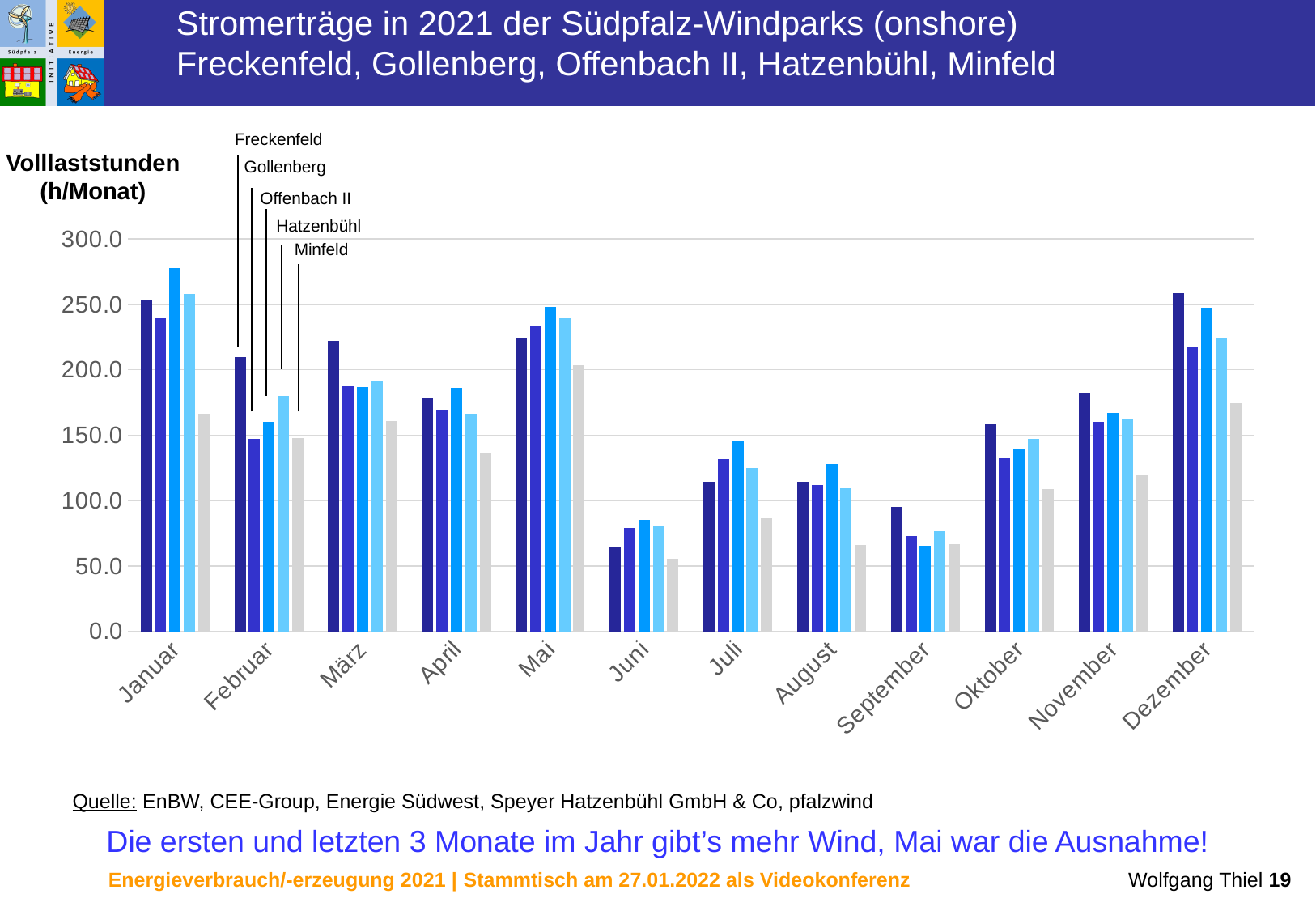
How many months are shown on the x axis of the chart? 12 Is the value for Minfeld in Dezember greater or less than 150? greater Do the values for all wind parks rise or fall from Mai to Juni? fall Is the value for Gollenberg in Juni greater or less than 100? less Is the value for Freckenfeld in März greater or less than 200? greater In which month does Freckenfeld have its lowest value? Juni What kind of chart is shown on the slide? bar chart In which month does Offenbach II reach its highest value? Januar How many wind parks (series) does the chart's legend list? 5 Which is larger: the value for Offenbach II in Mai or in Juni? Mai What is the label of the y axis of the chart? Volllaststunden (h/Monat)